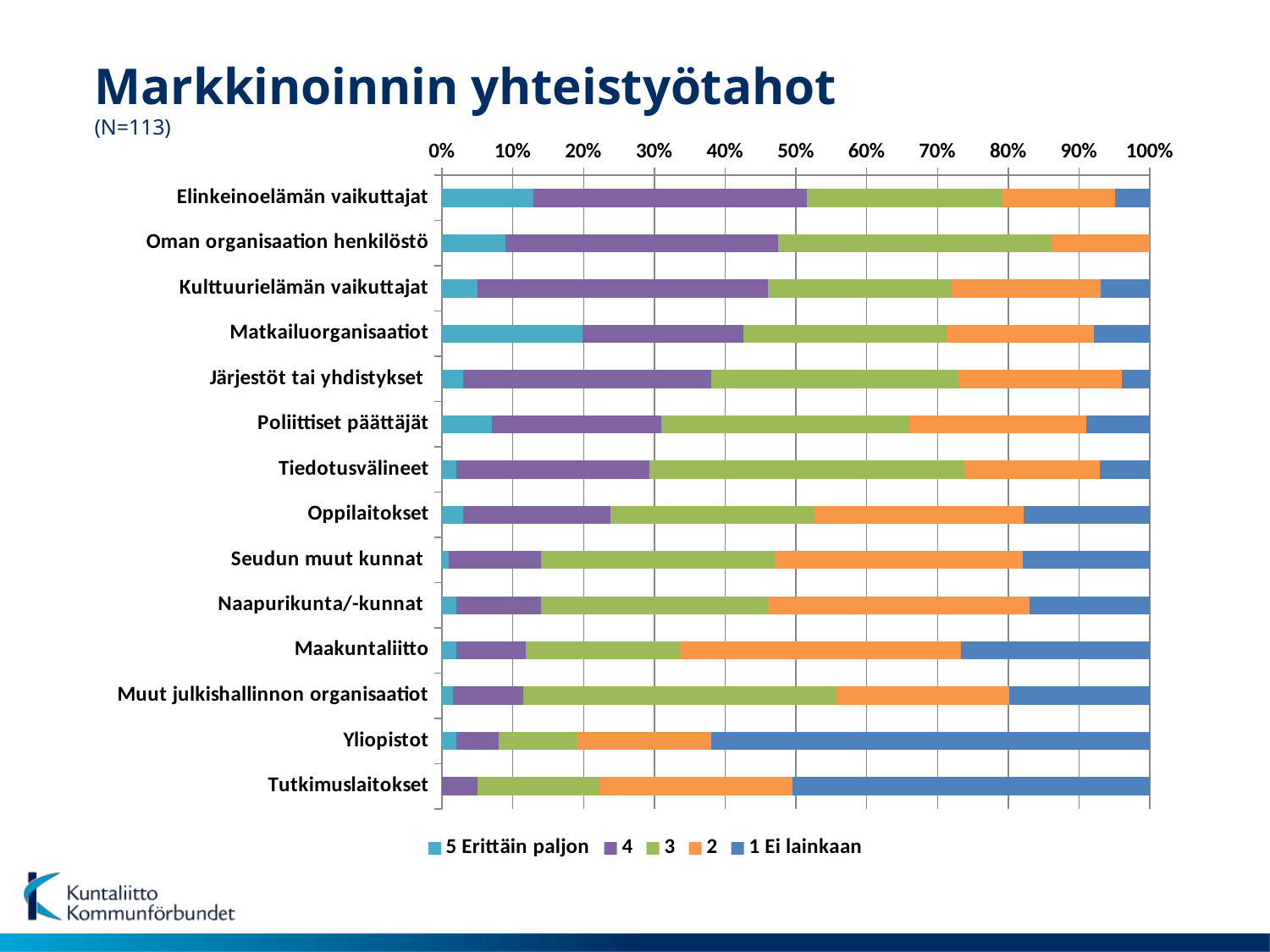
Which category has the largest '1 Ei lainkaan' share? Yliopistot Is the '1 Ei lainkaan' share for Oman organisaation henkilöstö greater or less than 10%? less Which category has the largest '5 Erittäin paljon' share? Matkailuorganisaatiot Is the '1 Ei lainkaan' share for Maakuntaliitto greater or less than 20%? greater Is the '5 Erittäin paljon' share for Elinkeinoelämän vaikuttajat greater or less than 10%? greater How many categories (cooperation partners) are listed on the chart? 14 What kind of chart is shown on the slide? Stacked bar chart What is the title of the chart? Markkinoinnin yhteistyötahot What is the sample size (N) shown under the chart title? 113 How many series does the legend list? 5 Which has the larger '1 Ei lainkaan' share, Maakuntaliitto or Oppilaitokset? Maakuntaliitto